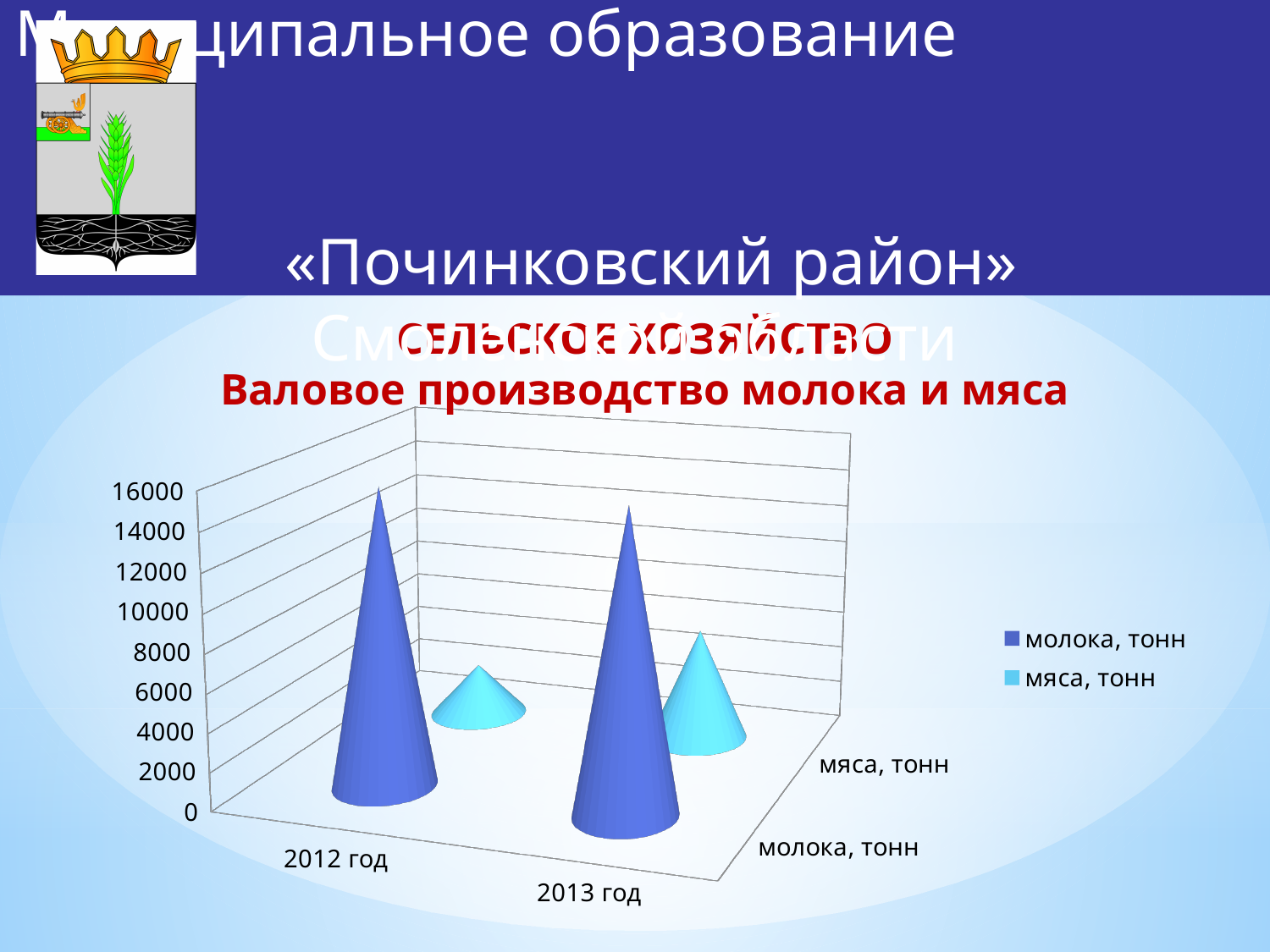
For мяса, тонн, which year has the larger value: 2012 год or 2013 год? 2013 год Is the value for молока, тонн in 2012 год greater or less than 10000? greater How many year categories are shown on the chart's x axis? 2 How many series does the chart legend list? 2 What kind of chart is shown on the slide? bar chart In 2012 год, which is larger: молока, тонн or мяса, тонн? молока, тонн Which series is shown in dark blue in the legend? молока, тонн Does the value for мяса, тонн rise or fall from 2012 год to 2013 год? rise Is the value for мяса, тонн in 2012 год greater or less than 10000? less Is the value for молока, тонн in 2013 год greater or less than 10000? greater What is the title of the chart? Валовое производство молока и мяса